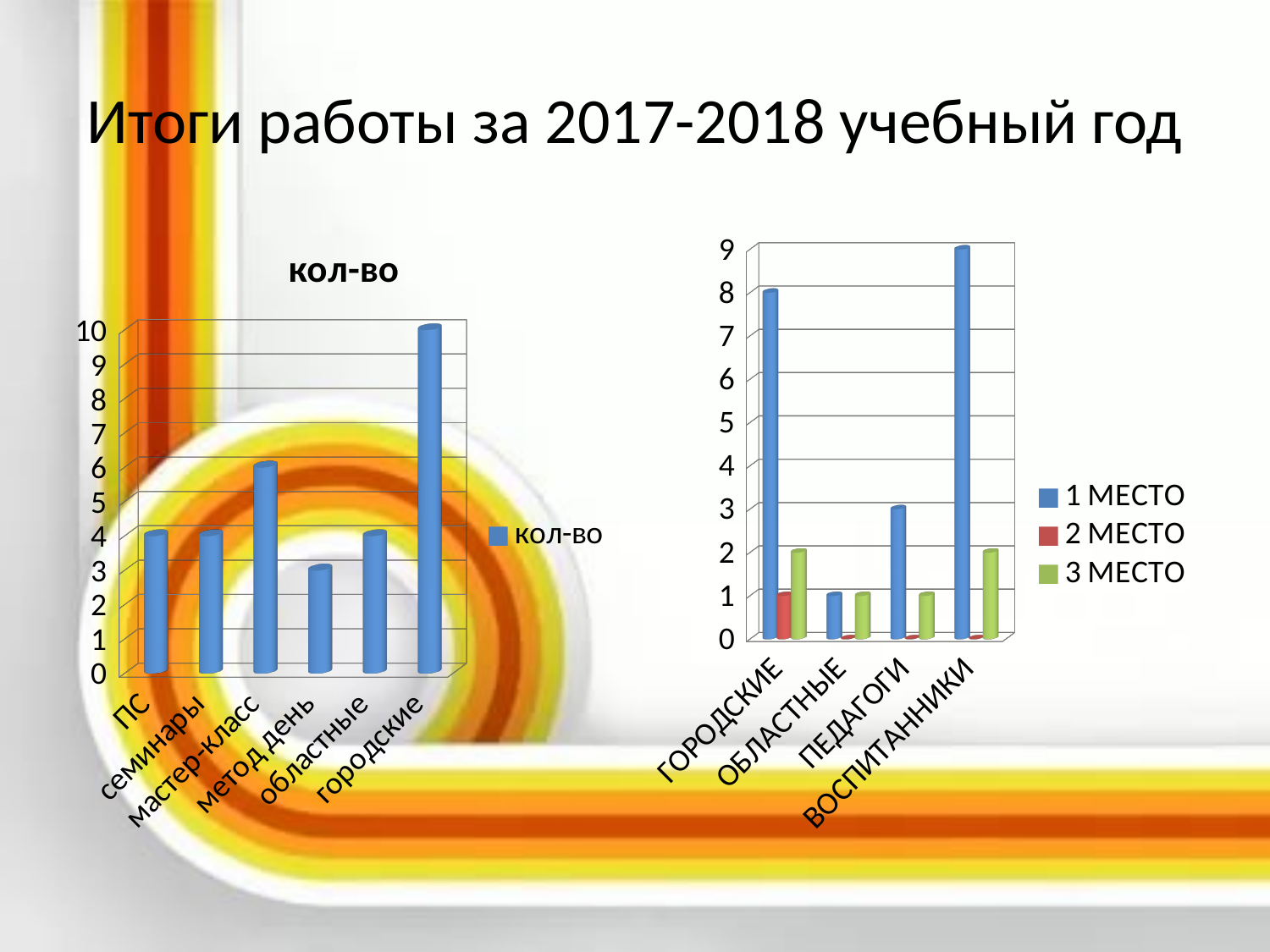
What kind of chart is the chart on the right side of the slide? bar chart On the right chart, which is larger for ПЕДАГОГИ, the value for 1 МЕСТО or the value for 3 МЕСТО? 1 МЕСТО On the left chart titled "кол-во", which category has the highest value? городские On the left chart titled "кол-во", is the value for мастер-класс greater or less than 5? greater On the right chart, what colour are the bars for 3 МЕСТО? green On the right chart, how many series does the legend list? 3 On the left chart titled "кол-во", is the value for городские greater or less than 8? greater On the left chart titled "кол-во", which category has the lowest value? метод день On the left chart titled "кол-во", which is larger, the value for мастер-класс or the value for метод день? мастер-класс On the right chart, which category has the highest value for 1 МЕСТО? ВОСПИТАННИКИ On the left chart titled "кол-во", how many categories are shown on the x axis? 6 On the right chart, is the value for 1 МЕСТО in ГОРОДСКИЕ greater or less than 7? greater